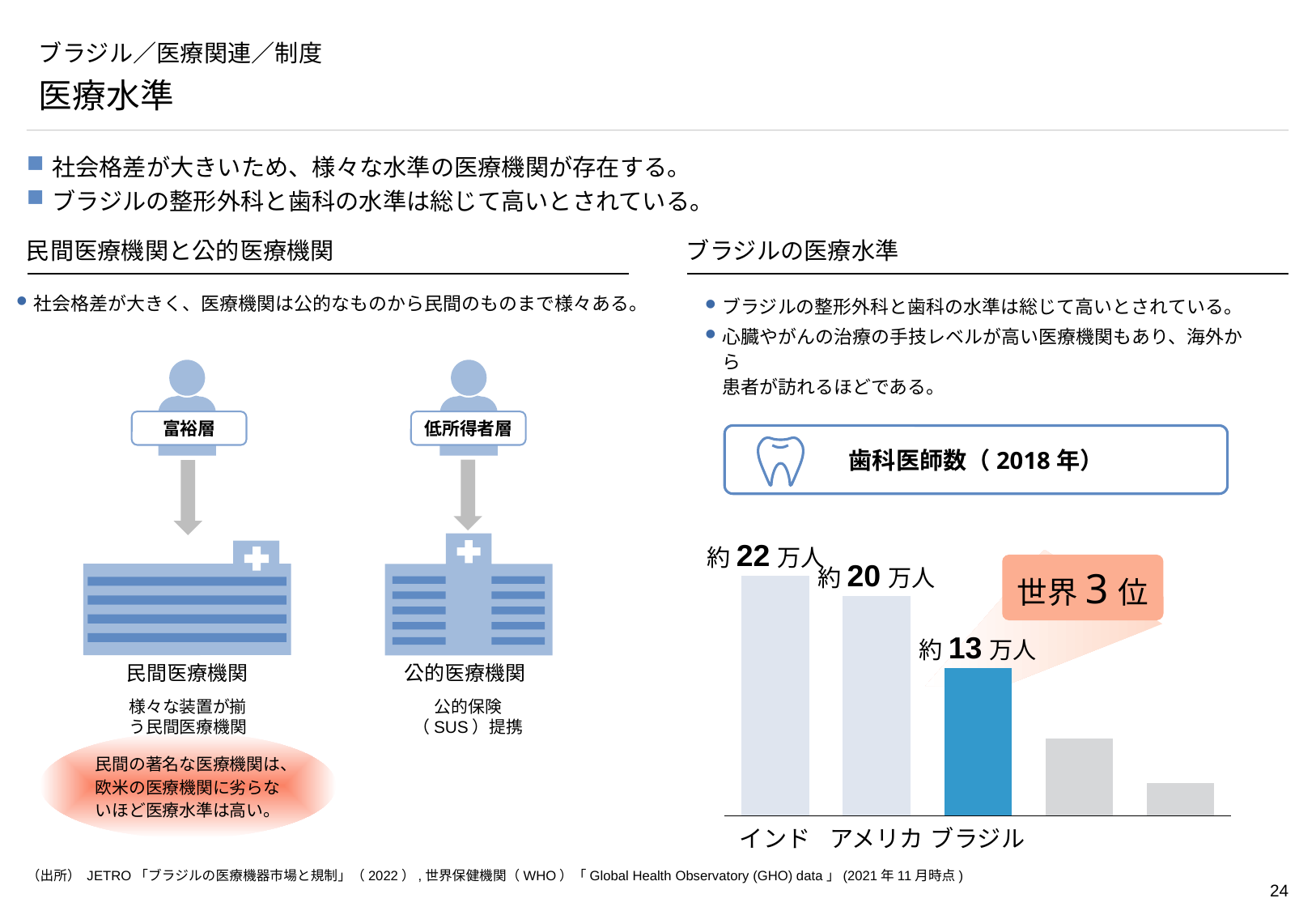
In the 歯科医師数（2018年） chart, which has more dentists, インド or アメリカ? インド In the 歯科医師数（2018年） chart, do the bar values rise or fall from left to right? fall In the 歯科医師数（2018年） chart, what is the data label shown for インド? 約22万人 How many countries are labeled on the x axis of the 歯科医師数（2018年） chart? 3 In the 歯科医師数（2018年） chart, what world ranking is annotated next to the ブラジル bar? 世界3位 What is the title of the bar chart on the right side of the slide? 歯科医師数（2018年） In the 歯科医師数（2018年） chart, what is the data label shown for ブラジル? 約13万人 What kind of chart is shown under 歯科医師数（2018年）? bar chart In the 歯科医師数（2018年） chart, what is the data label shown for アメリカ? 約20万人 In the 歯科医師数（2018年） chart, which labeled country has the highest number of dentists? インド In the 歯科医師数（2018年） chart, which has more dentists, アメリカ or ブラジル? アメリカ In the 歯科医師数（2018年） chart, which of the three labeled countries has the lowest number of dentists? ブラジル